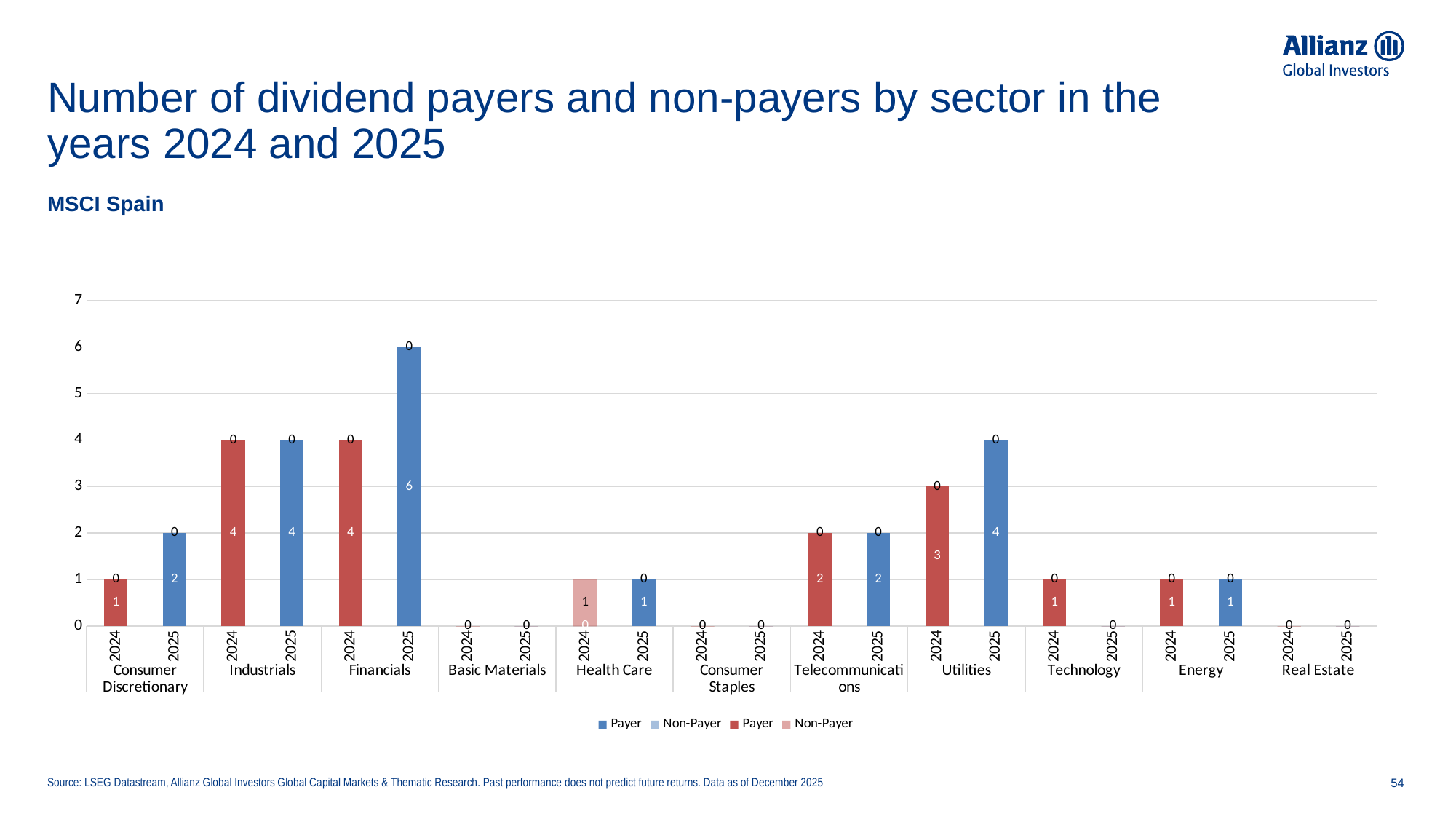
How many dividend payers does the Utilities sector have in 2024? 3 What is the difference between the number of dividend payers in Financials in 2025 and in 2024? 2 How many dividend non-payers does the Health Care sector have in 2024? 1 How many dividend payers does the Financials sector have in 2025? 6 Which index does the chart cover, according to the subtitle? MSCI Spain How many dividend payers does the Technology sector have in 2025? 0 By how much did the number of dividend payers in Utilities increase from 2024 to 2025? 1 For Consumer Discretionary, which year has more dividend payers, 2024 or 2025? 2025 What type of chart is shown on the slide? Bar chart Which sector has the highest number of dividend payers in 2025? Financials How many entries does the chart legend list? 4 How many sectors are shown on the x axis of the chart? 11